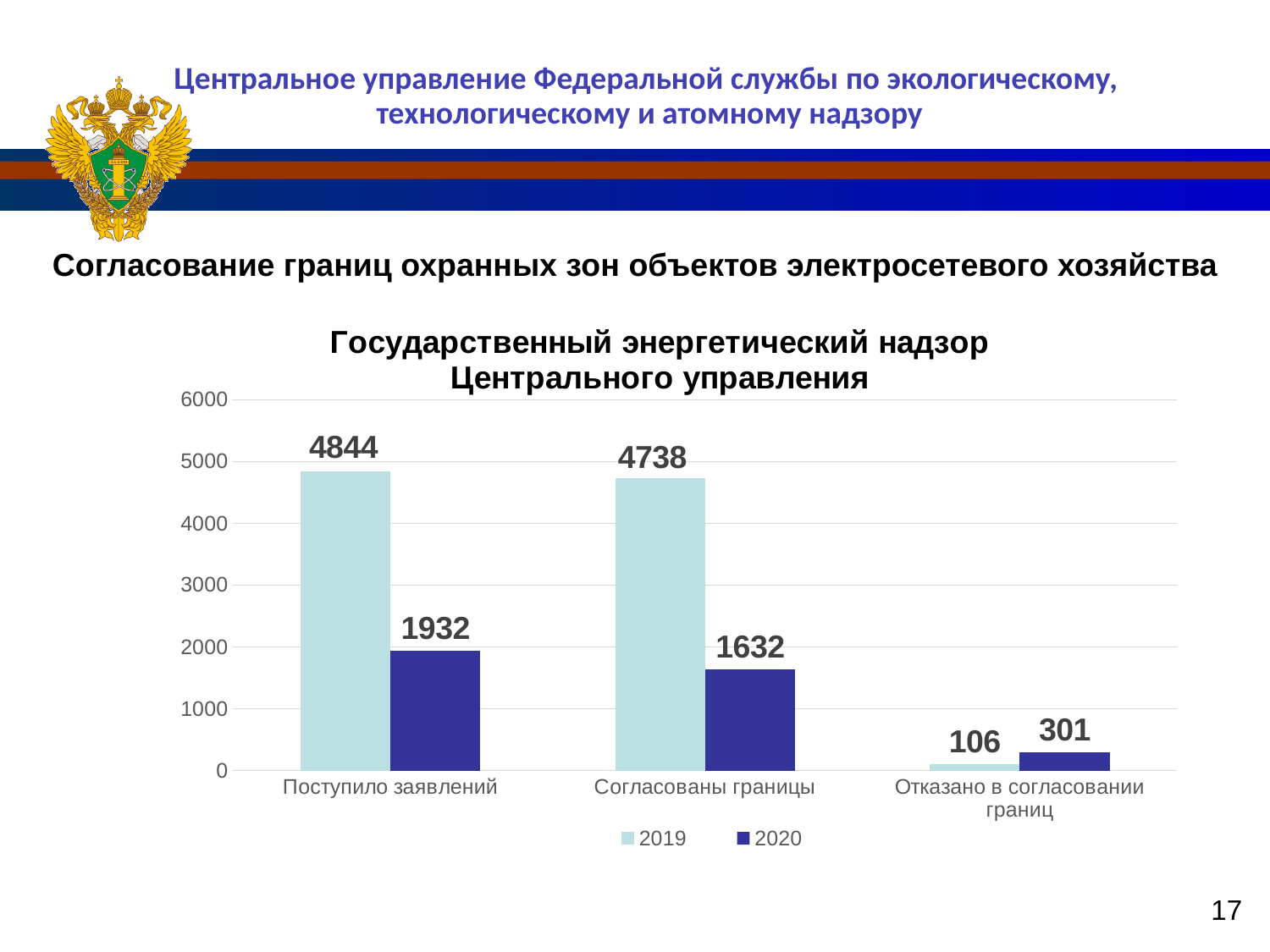
How many categories are shown on the x axis? 3 Which category has the highest 2019 value? Поступило заявлений Is the 2020 value for Согласованы границы greater or less than 2000? less Which is larger for Отказано в согласовании границ: the 2019 value or the 2020 value? 2020 Which category has the lowest 2020 value? Отказано в согласовании границ What is the title of the chart? Государственный энергетический надзор Центрального управления What is the 2020 value for Отказано в согласовании границ? 301 What kind of chart is shown on the slide? bar chart What is the 2019 value for Поступило заявлений? 4844 What is the difference between the 2019 and 2020 values for Поступило заявлений? 2912 What is the 2020 value for Согласованы границы? 1632 How many series does the legend list? 2